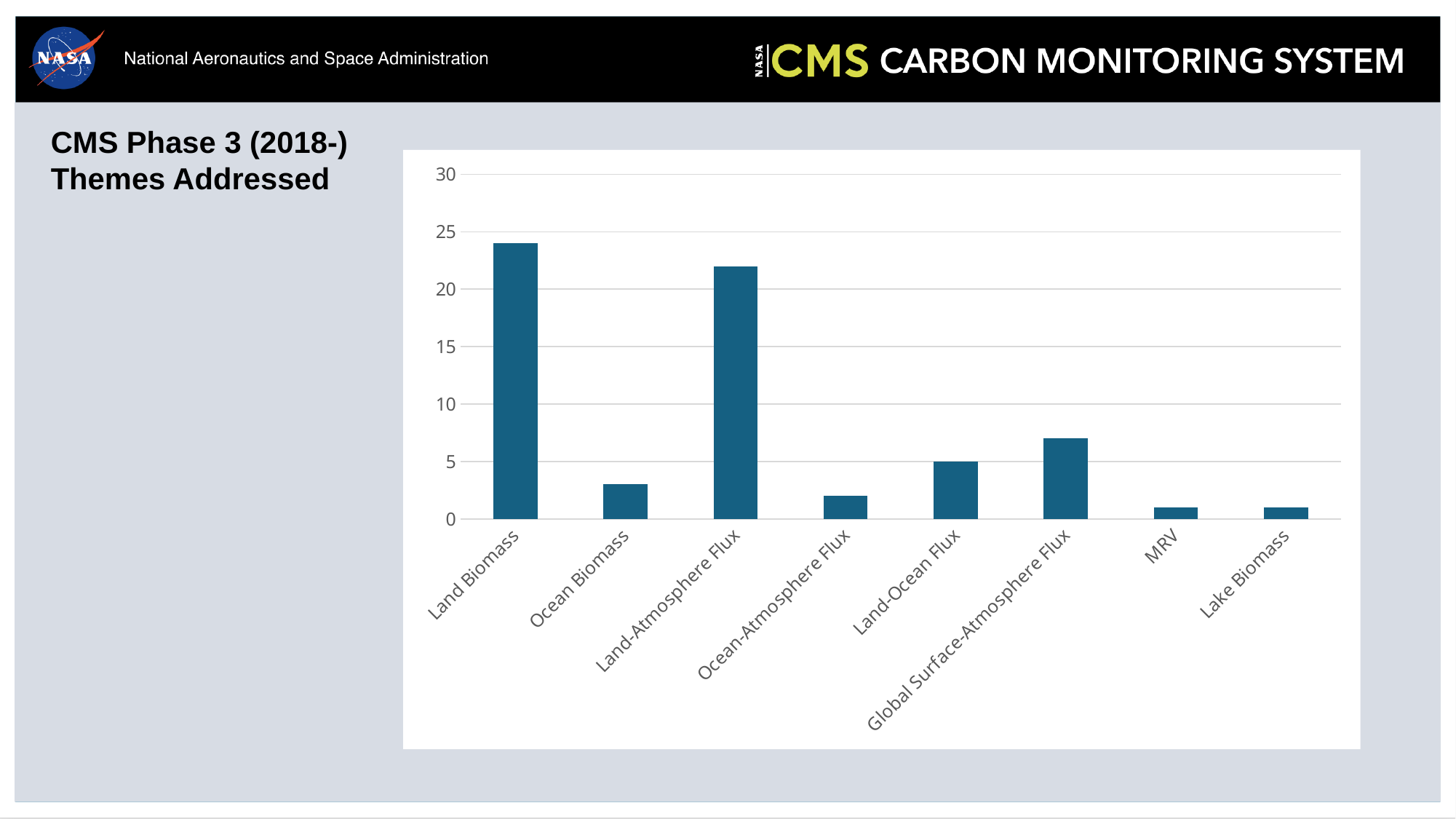
How many categories are shown on the x axis of the chart? 8 What is the title given for the chart on the slide? CMS Phase 3 (2018-) Themes Addressed Which is larger, the value for Land Biomass or the value for Land-Atmosphere Flux? Land Biomass What kind of chart is shown on the slide? bar chart Is the value for Global Surface-Atmosphere Flux greater or less than 5? greater Is the value for Land Biomass greater or less than 20? greater Which is larger, the value for Global Surface-Atmosphere Flux or the value for Ocean Biomass? Global Surface-Atmosphere Flux What is the value for Land-Ocean Flux? 5 Which category has the highest bar in the chart? Land Biomass Is the value for Land-Atmosphere Flux greater or less than 25? less